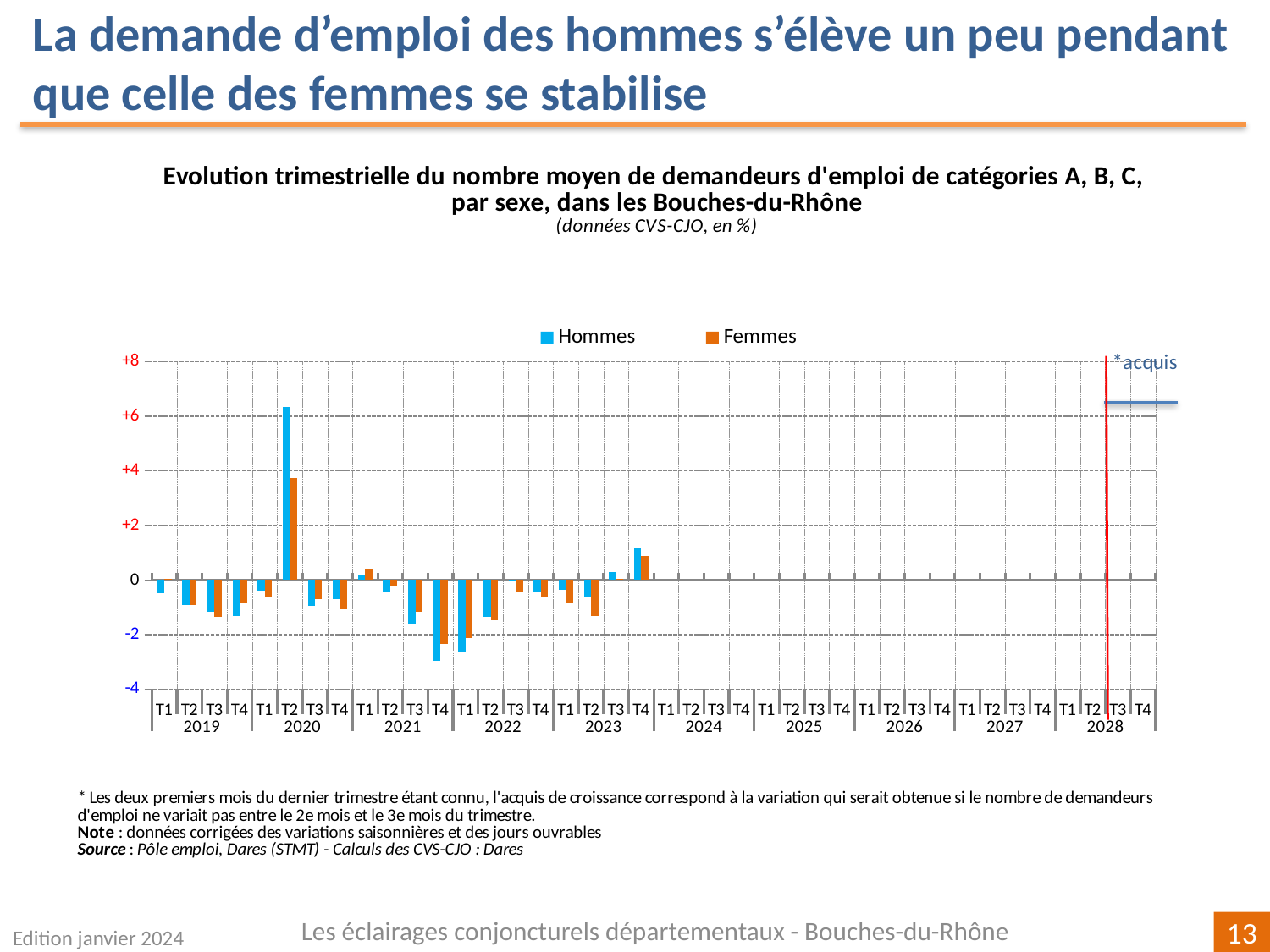
In which quarter is the value for Femmes highest? T2 2020 What label is written next to the red vertical line at the right of the chart? *acquis In which quarter is the value for Hommes highest? T2 2020 What kind of chart is shown on the slide? bar chart What are the two series named in the legend? Hommes and Femmes Is the value for Hommes in T4 2023 greater or less than +2? less In which quarter is the value for Hommes lowest? T4 2021 How many series does the legend list? 2 In T2 2020, which series has the larger value, Hommes or Femmes? Hommes Is the value for Hommes in T4 2021 greater or less than -2? less Is the value for Femmes in T2 2020 greater or less than +2? greater